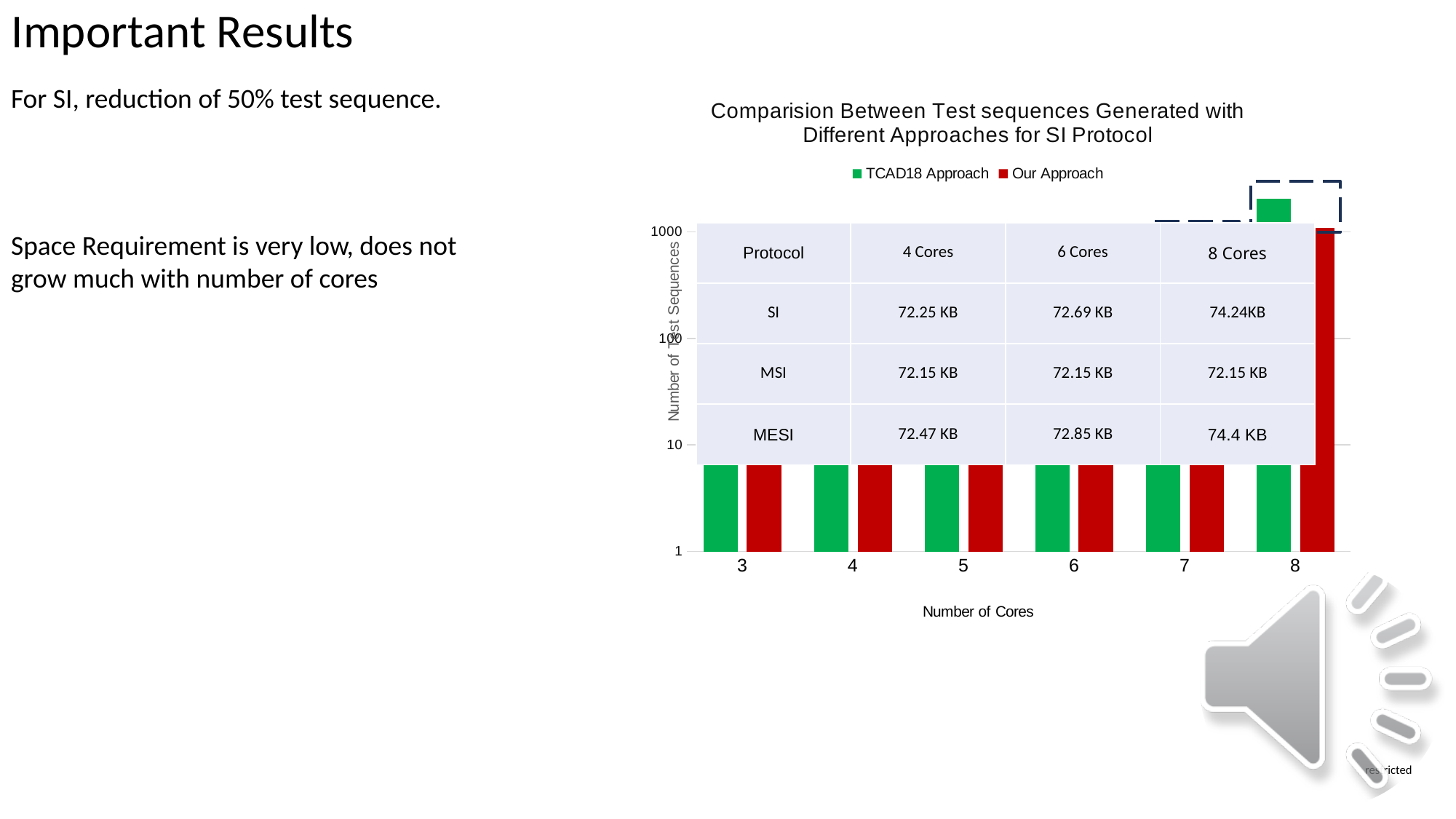
What kind of chart is shown on the slide? bar chart What is the label of the x axis of the chart? Number of Cores How many core counts (categories) are shown along the x axis of the chart? 6 Is the value for Our Approach at 8 cores greater or less than 100? greater Which two approaches are listed in the chart's legend? TCAD18 Approach and Our Approach How many series does the legend of the chart list? 2